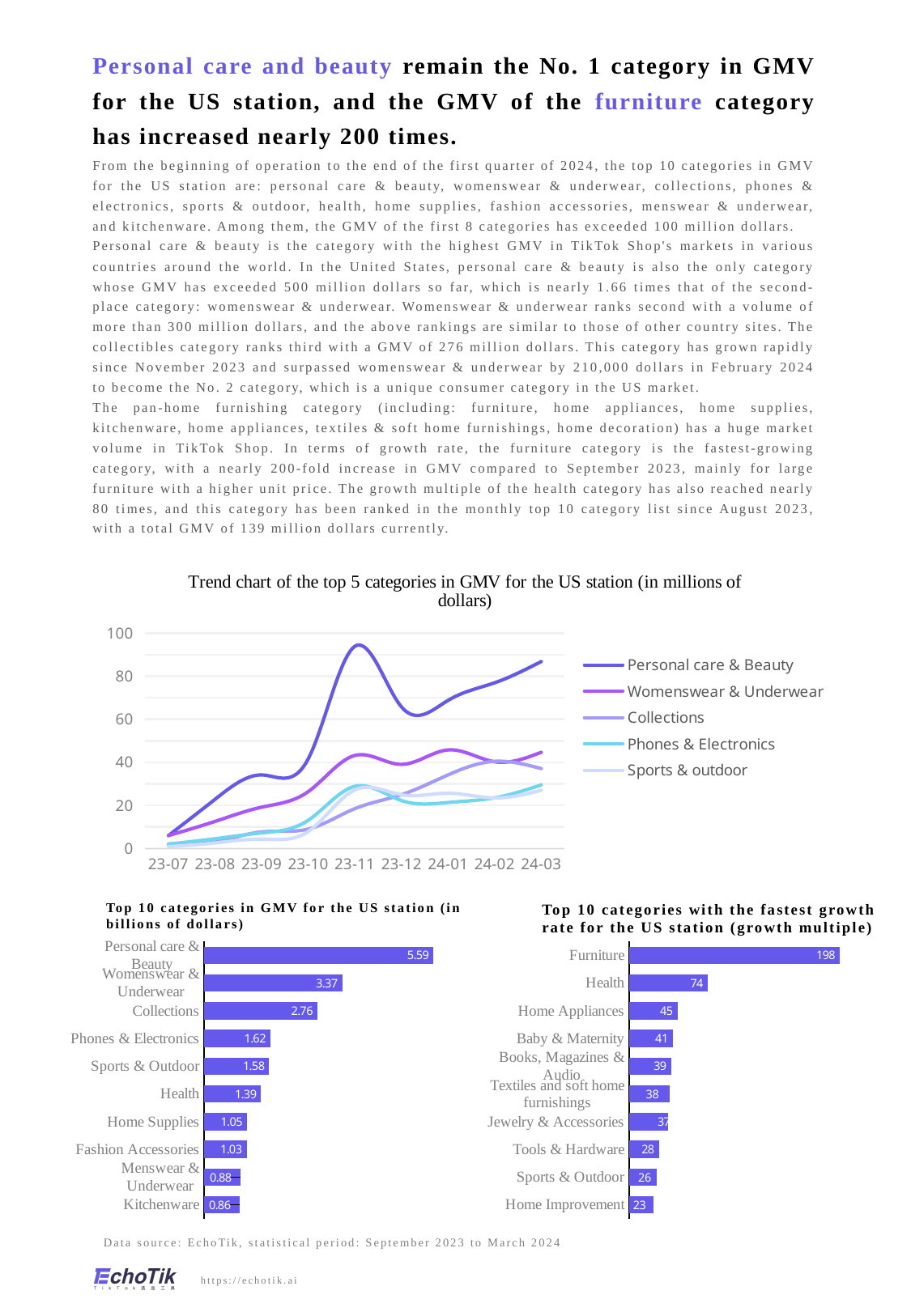
In the 'Trend chart of the top 5 categories in GMV for the US station', is the value for Personal care & Beauty at 23-11 greater or less than 80? greater In the 'Top 10 categories with the fastest growth rate for the US station' chart, what is the difference between Furniture and Home Appliances? 153 In the 'Top 10 categories in GMV for the US station' chart, which is larger: Health or Home Supplies? Health In the 'Top 10 categories with the fastest growth rate for the US station' chart, which category has the highest growth multiple? Furniture In the 'Top 10 categories with the fastest growth rate for the US station' chart, what is the growth multiple for Health? 74 In the 'Top 10 categories in GMV for the US station' chart, which category has the lowest value? Kitchenware In the 'Top 10 categories with the fastest growth rate for the US station' chart, how many categories are shown? 10 In the 'Top 10 categories in GMV for the US station' chart, what is the difference between Personal care & Beauty and Womenswear & Underwear? 2.22 How many series does the legend of the 'Trend chart of the top 5 categories in GMV for the US station' list? 5 In the 'Top 10 categories in GMV for the US station' chart, what is the value for Collections? 2.76 What kind of chart is the 'Trend chart of the top 5 categories in GMV for the US station'? Line chart In the 'Trend chart of the top 5 categories in GMV for the US station', which series has the highest value at 24-03? Personal care & Beauty